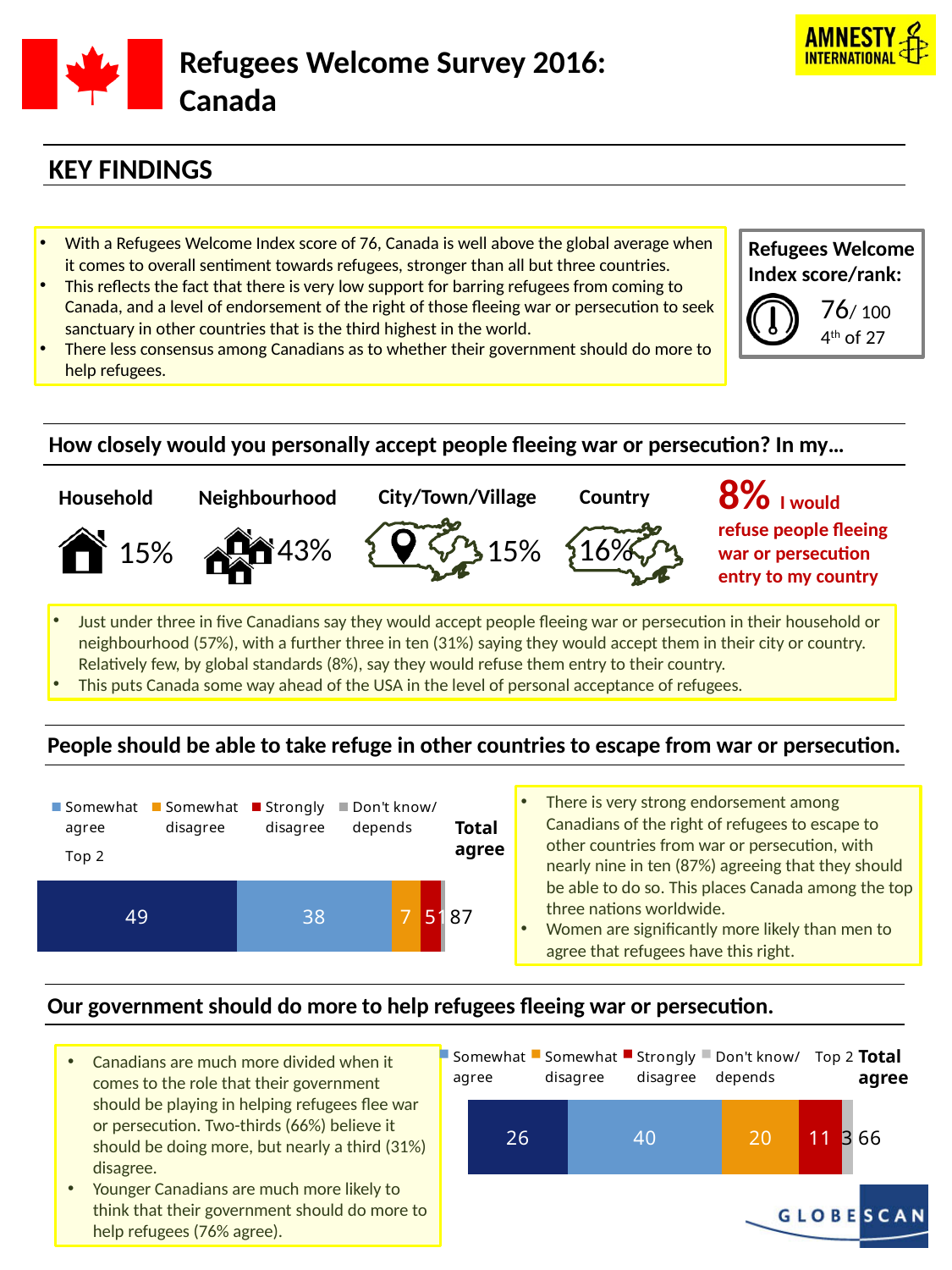
In the chart under 'Our government should do more to help refugees fleeing war or persecution', what is the value for 'Strongly disagree'? 11 Which chart has the higher 'Total agree' figure: the one under 'People should be able to take refuge in other countries...' or the one under 'Our government should do more to help refugees...'? People should be able to take refuge in other countries... In the chart under 'Our government should do more to help refugees fleeing war or persecution', what is the value for 'Somewhat disagree'? 20 In the chart under 'People should be able to take refuge in other countries to escape from war or persecution', which is larger: 'Somewhat disagree' or 'Strongly disagree'? Somewhat disagree In the chart under 'People should be able to take refuge in other countries to escape from war or persecution', what is the value for 'Strongly disagree'? 5 In the chart under 'Our government should do more to help refugees fleeing war or persecution', what is the value for 'Somewhat agree'? 40 In the chart under 'Our government should do more to help refugees fleeing war or persecution', what is the difference between the 'Somewhat agree' and 'Somewhat disagree' values? 20 In the chart under 'Our government should do more to help refugees fleeing war or persecution', what is the 'Total agree' figure shown at the end of the bar? 66 In the chart under 'People should be able to take refuge in other countries to escape from war or persecution', what is the 'Total agree' figure shown at the end of the bar? 87 In the chart under 'People should be able to take refuge in other countries to escape from war or persecution', what is the value for 'Don't know/depends'? 1 In the chart under 'People should be able to take refuge in other countries to escape from war or persecution', what is the value for 'Somewhat agree'? 38 What kind of chart is used under 'Our government should do more to help refugees fleeing war or persecution'? Stacked bar chart